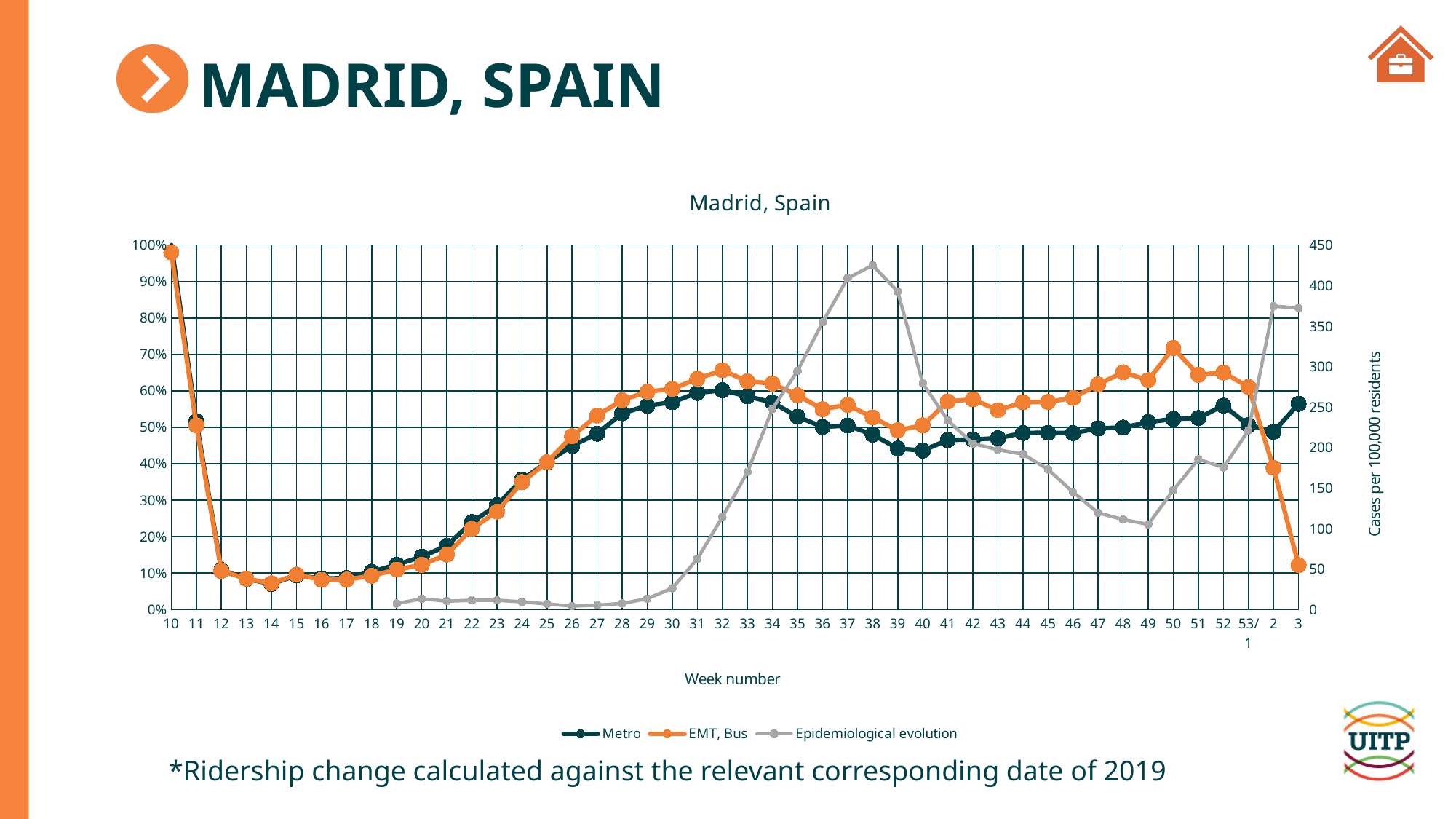
How many series does the legend list? 3 What is the title of the chart? Madrid, Spain Is the value for Epidemiological evolution at week 38 greater or less than 400? greater What is the label of the right-hand vertical axis? Cases per 100,000 residents Is the value for EMT, Bus at week 3 greater or less than 20%? less Does the Metro series rise or fall between week 12 and week 32? Rise At which week does the Epidemiological evolution series reach its highest value? 38 At week 50, which series is higher, Metro or EMT, Bus? EMT, Bus Is the value for EMT, Bus at week 50 greater or less than 60%? greater What kind of chart is shown on the slide? Line chart How many week categories are shown on the x axis? 46